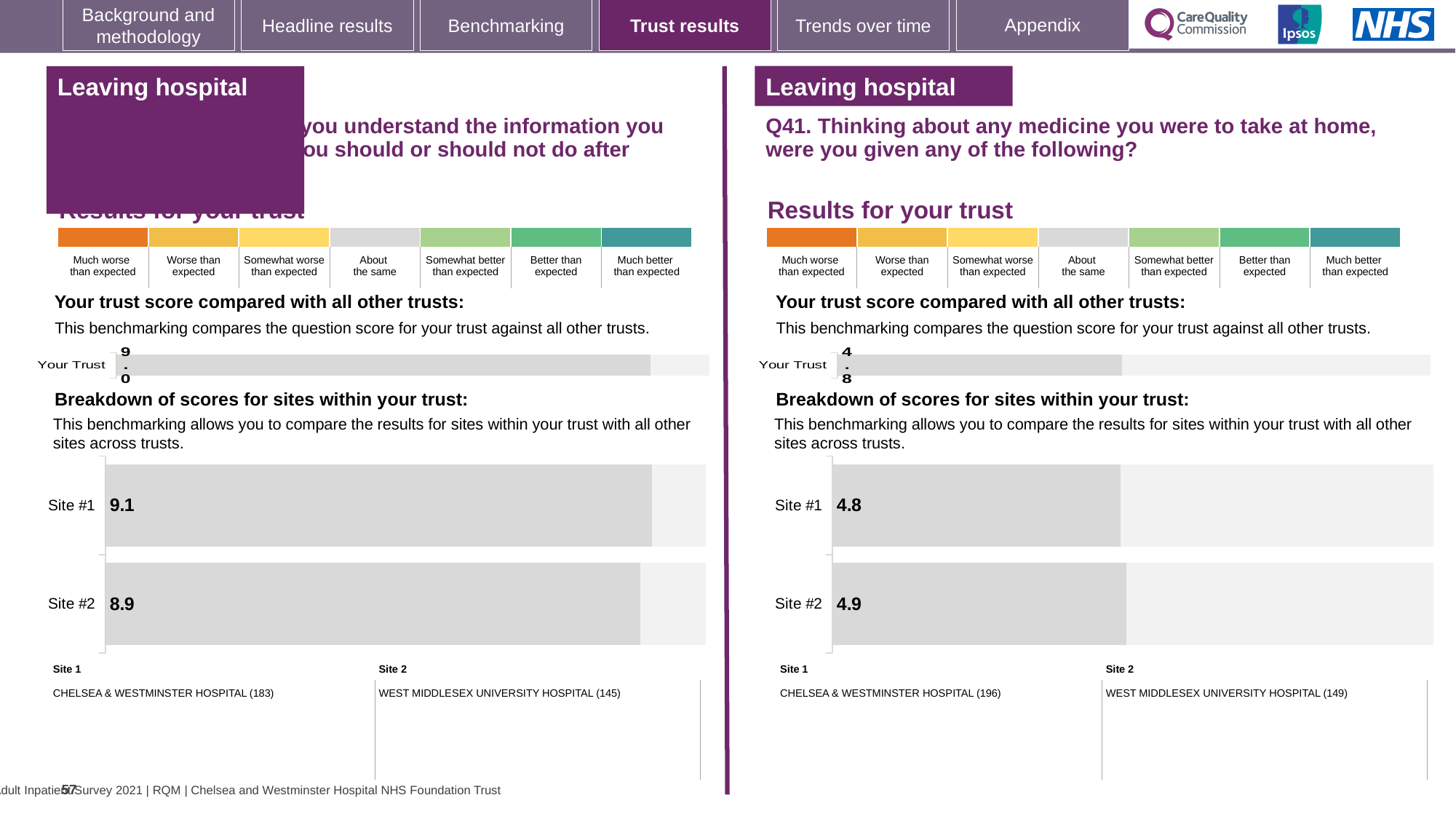
On the right-hand site breakdown chart (Q41), what is the difference between the Site #2 and Site #1 scores? 0.1 On the left-hand chart, what is the score for Site #2? 8.9 On the left-hand chart, what is the score shown for Your Trust? 9.0 How many sites are shown in the site breakdown chart on the right-hand side (Q41)? 2 On the left-hand chart, what is the score for Site #1? 9.1 On the left-hand site breakdown chart, what is the difference between the Site #1 and Site #2 scores? 0.2 On the right-hand chart (Q41), what is the score for Site #2? 4.9 On the right-hand site breakdown chart (Q41), which site has the lower score? Site #1 What type of chart is used for the site breakdown on the left-hand side? Bar chart On the left-hand site breakdown chart, which site has the higher score? Site #1 On the right-hand chart (Q41), what is the score shown for Your Trust? 4.8 On the right-hand chart (Q41), what is the score for Site #1? 4.8